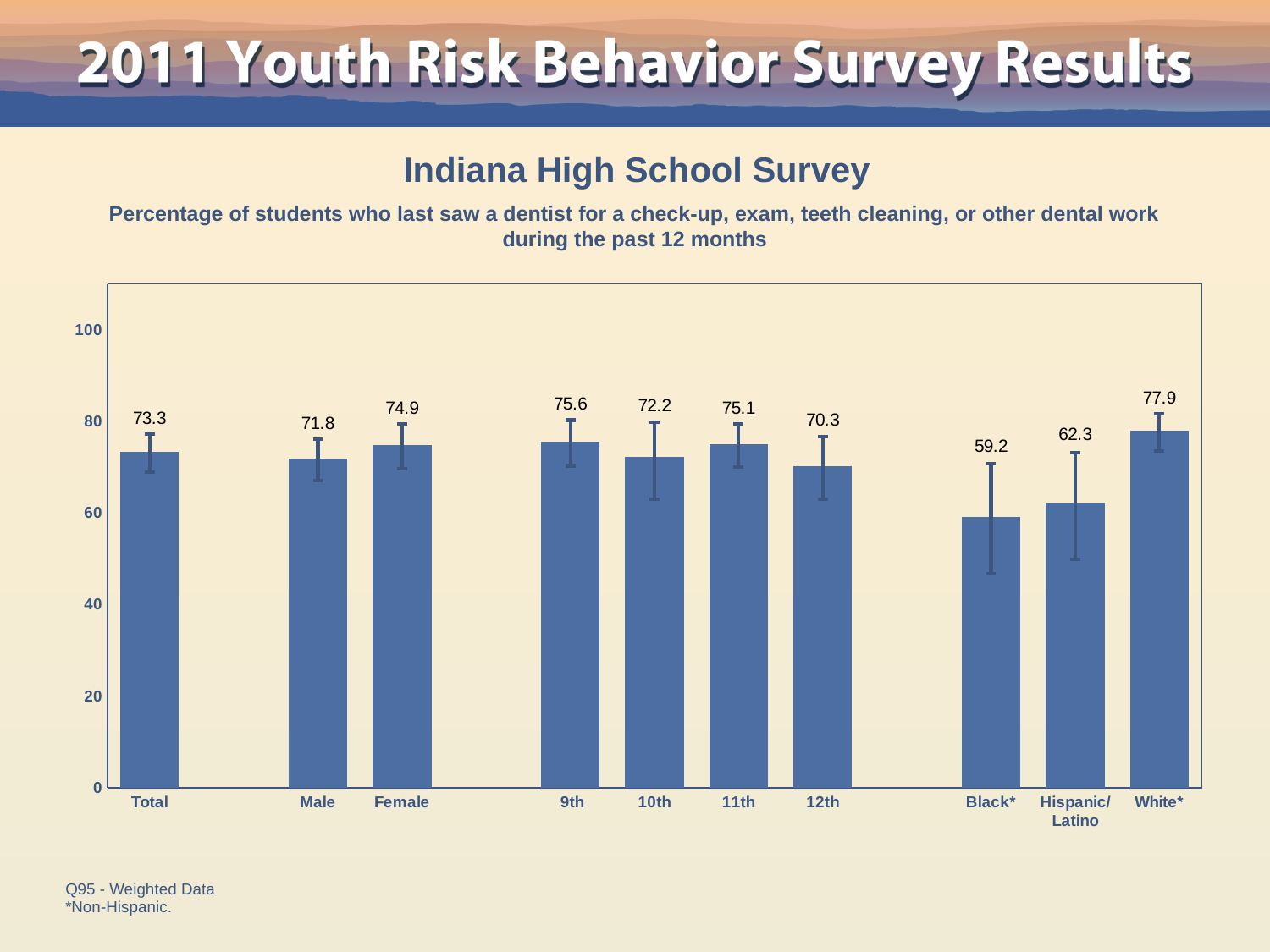
What is the value for Hispanic/Latino students? 62.3 Which category has the lowest value? Black* What is the difference between the White* and Black* values? 18.7 Which category has the highest value? White* What is the value for 10th graders? 72.2 How many categories are shown on the x axis? 10 What kind of chart is this? bar chart Is the value for Black* greater or less than 60? less What is the value for Total? 73.3 What is the difference between the Female and Male values? 3.1 Which is larger, the value for 9th graders or 12th graders? 9th